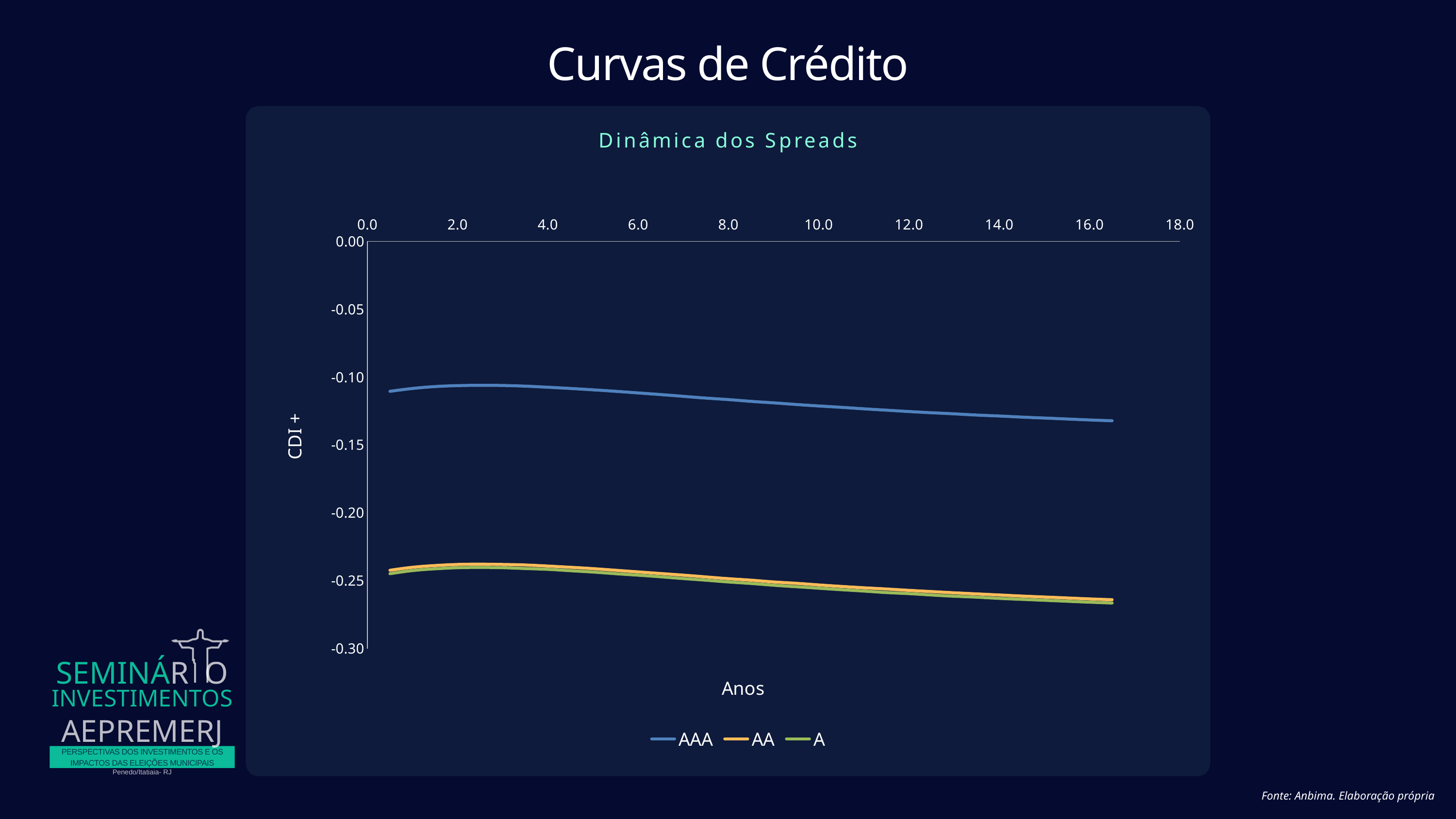
In the "Dinâmica dos Spreads" chart, which is larger at 16.0 years: the AAA value or the AA value? AAA What colour is the AAA line in the "Dinâmica dos Spreads" chart? blue What kind of chart is shown under the title "Dinâmica dos Spreads"? line chart What is the label of the x axis in the "Dinâmica dos Spreads" chart? Anos In the "Dinâmica dos Spreads" chart, is the AAA value at 8.0 years greater or less than -0.15? greater Which series in the "Dinâmica dos Spreads" chart has the highest values across the whole x axis? AAA In the "Dinâmica dos Spreads" chart, does the AAA line rise or fall from 4.0 years to 16.0 years? fall In the "Dinâmica dos Spreads" chart, is the A value near 0.0 years greater or less than -0.20? less In the "Dinâmica dos Spreads" chart, is the AA value at 16.0 years greater or less than -0.25? less How many series does the legend of the "Dinâmica dos Spreads" chart list? 3